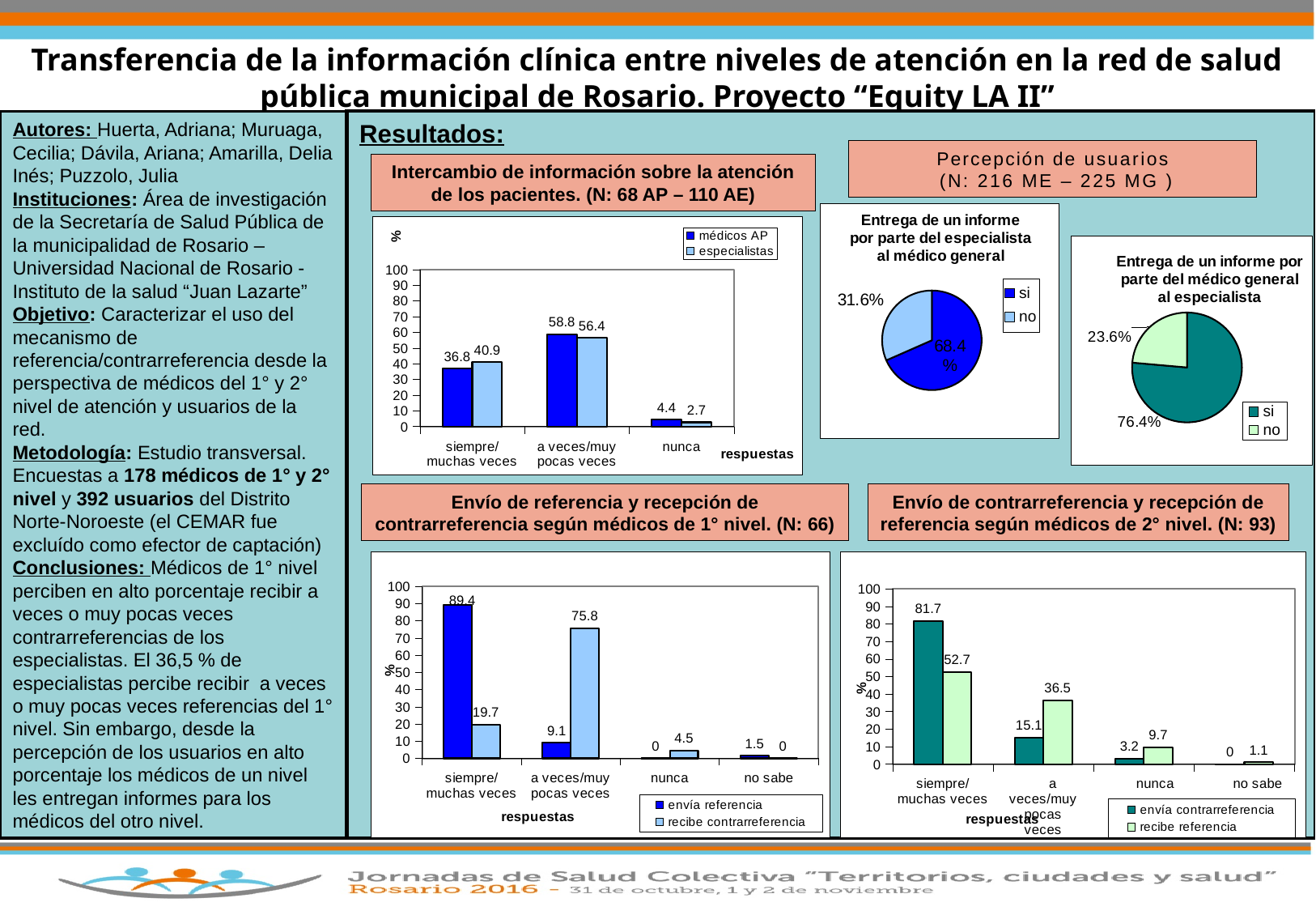
In the pie chart 'Entrega de un informe por parte del médico general al especialista', what share of the pie is 'no'? 23.6% In the chart 'Envío de contrarreferencia y recepción de referencia según médicos de 2° nivel', what is the value for envía contrarreferencia in the 'siempre/muchas veces' category? 81.7 In the chart 'Envío de referencia y recepción de contrarreferencia según médicos de 1° nivel', which category has the highest value for envía referencia? siempre/muchas veces What kind of chart is 'Entrega de un informe por parte del médico general al especialista'? pie chart In the chart 'Intercambio de información sobre la atención de los pacientes', what is the value for médicos AP in the 'a veces/muy pocas veces' category? 58.8 In the chart 'Envío de contrarreferencia y recepción de referencia según médicos de 2° nivel', which is larger in the 'nunca' category: envía contrarreferencia or recibe referencia? recibe referencia In the chart 'Envío de contrarreferencia y recepción de referencia según médicos de 2° nivel', how many categories are shown on the x axis? 4 In the chart 'Intercambio de información sobre la atención de los pacientes', what is the difference between médicos AP and especialistas in the 'nunca' category? 1.7 In the chart 'Envío de referencia y recepción de contrarreferencia según médicos de 1° nivel', what is the value for recibe contrarreferencia in the 'a veces/muy pocas veces' category? 75.8 In the pie chart 'Entrega de un informe por parte del especialista al médico general', what share of the pie is 'si'? 68.4% In the chart 'Intercambio de información sobre la atención de los pacientes', what is the value for especialistas in the 'siempre/muchas veces' category? 40.9 In the chart 'Intercambio de información sobre la atención de los pacientes', how many series does the legend list? 2